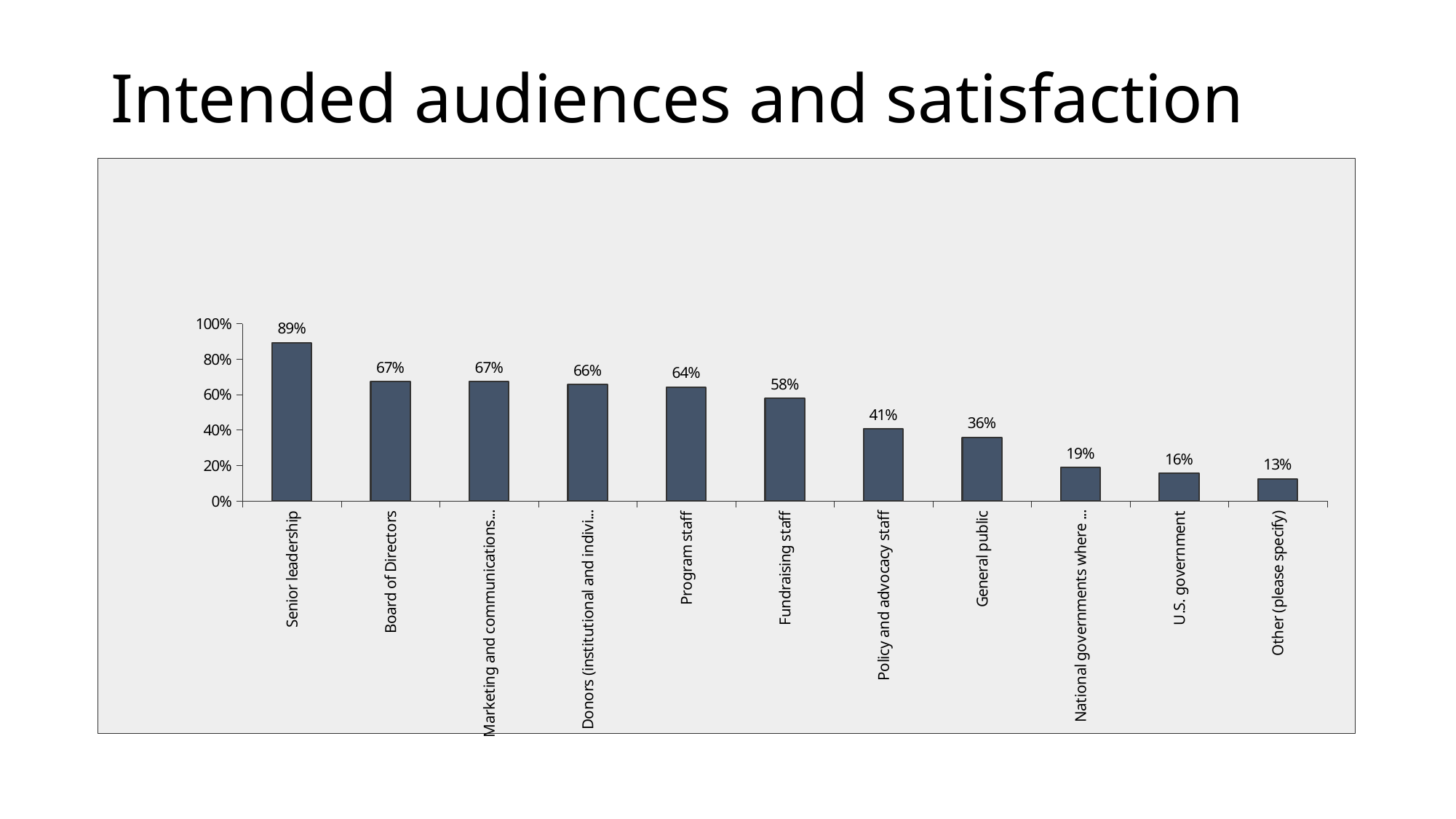
What is the difference between the values for Senior leadership and Board of Directors? 22% Do the values rise or fall from left to right along the x axis? Fall How many categories are shown on the x axis? 11 What is the value for Program staff? 64% Which category has the highest value? Senior leadership What is the difference between the values for Fundraising staff and Policy and advocacy staff? 17% Which category has the lowest value? Other (please specify) Which is larger, the value for Program staff or the value for Fundraising staff? Program staff What is the value for Senior leadership? 89% What kind of chart is shown on the slide? Bar chart What is the value for General public? 36% What is the value for U.S. government? 16%